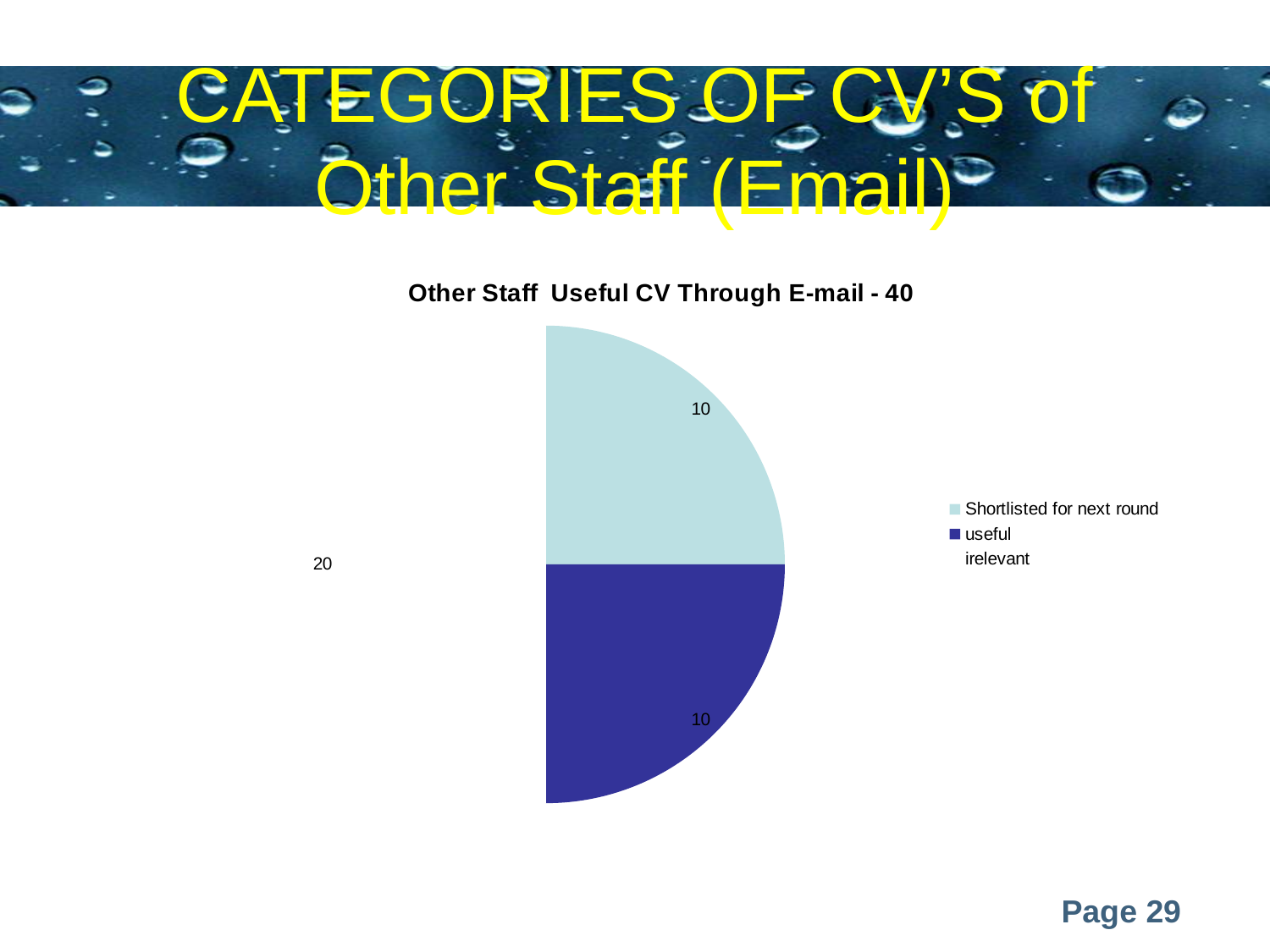
Which legend entry is shown in dark blue? useful What is the title of the chart? Other Staff Useful CV Through E-mail - 40 Which category has the highest value? irelevant What is the difference between the value for 'irelevant' and the value for 'useful'? 10 What share of the pie does 'irelevant' represent? 50% What share of the pie does 'Shortlisted for next round' represent? 25% What is the value for 'irelevant'? 20 What is the value for 'Shortlisted for next round'? 10 What is the total of all the values in the chart? 40 What is the value for 'useful'? 10 What type of chart is shown on the slide? pie chart How many entries does the chart legend list? 3